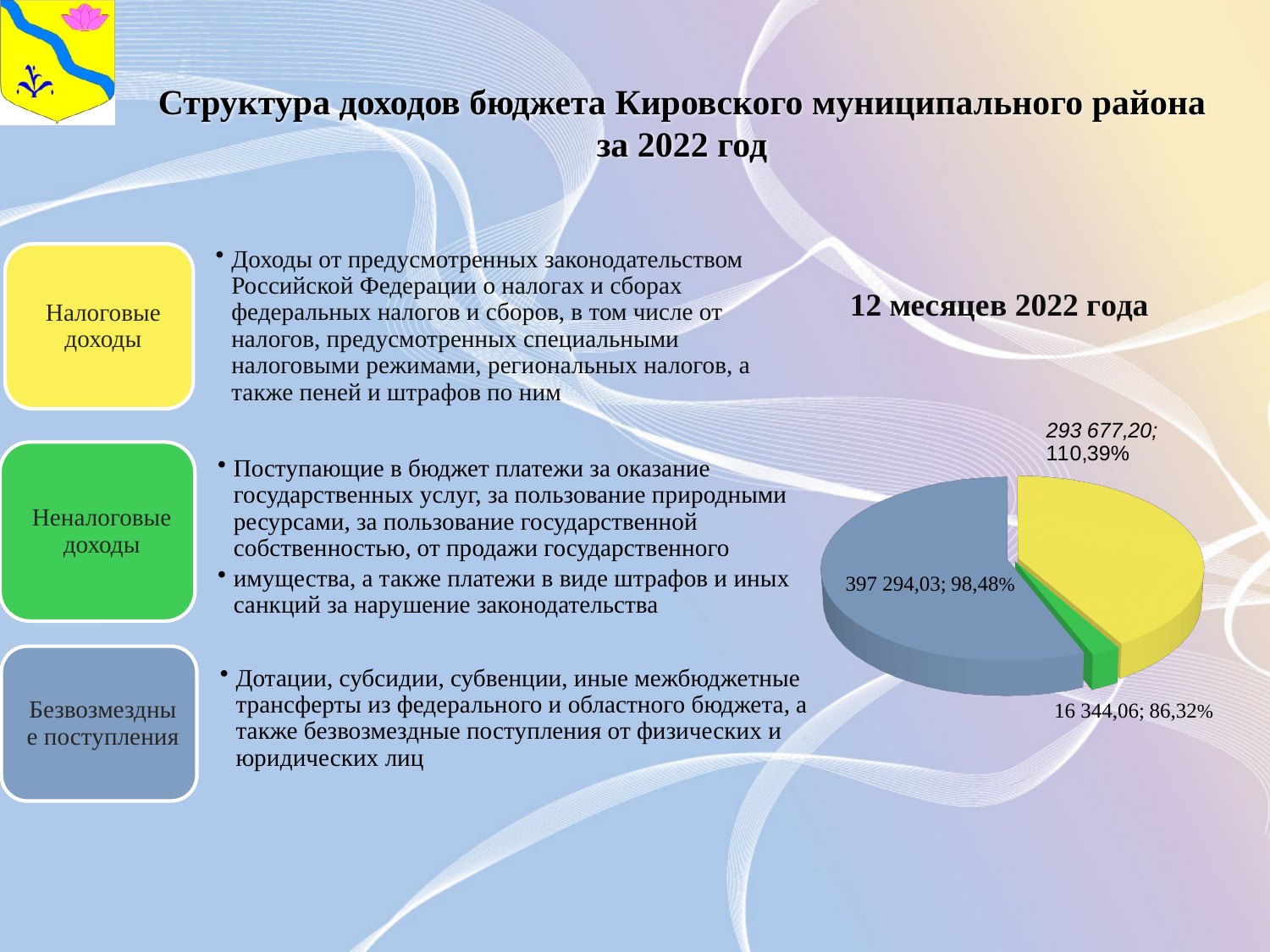
What is the difference between the value of the blue-grey slice and the value of the yellow slice in the pie chart? 103 616,83 What kind of chart is shown on the slide? Pie chart What is the title of the pie chart? 12 месяцев 2022 года What value is labelled on the green slice of the pie chart? 16 344,06 What value is labelled on the yellow slice of the pie chart? 293 677,20 How many slices does the pie chart have? 3 What percentage is printed next to the yellow slice of the pie chart? 110,39% What percentage is printed next to the blue-grey slice of the pie chart? 98,48% Which slice of the pie chart has the smallest value? The green slice (16 344,06) What percentage is printed next to the green slice of the pie chart? 86,32% What value is labelled on the blue-grey slice of the pie chart? 397 294,03 Which slice of the pie chart has the largest value? The blue-grey slice (397 294,03)